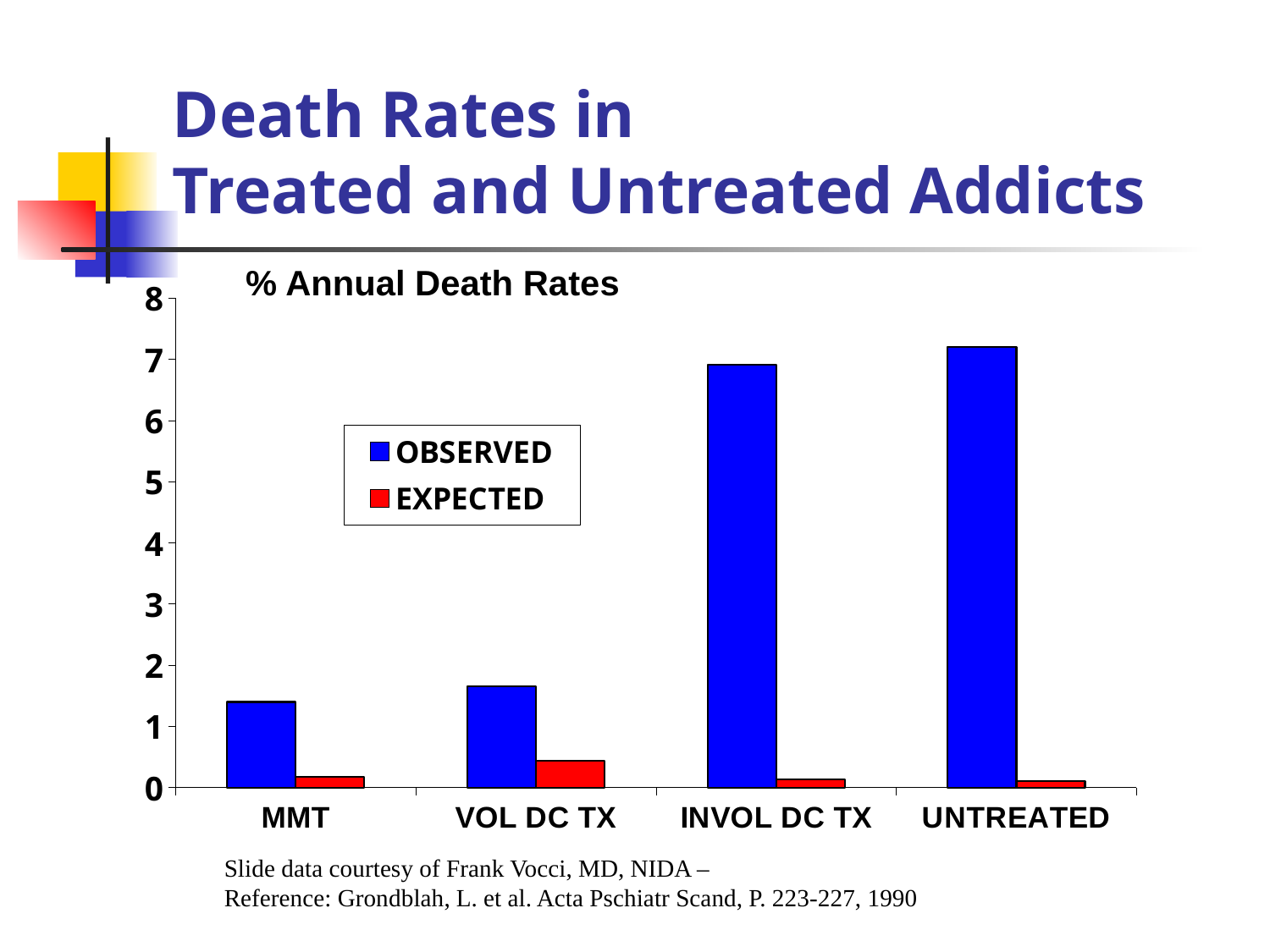
Is the EXPECTED value for VOL DC TX greater or less than 1? less Is the OBSERVED value for UNTREATED greater or less than 6? greater Is the OBSERVED value for VOL DC TX greater or less than 2? less What kind of chart is shown on the slide? bar chart Which is larger, the OBSERVED value for MMT or the OBSERVED value for VOL DC TX? VOL DC TX How many series does the legend list? 2 What colour are the EXPECTED bars? red How many categories are shown on the x axis? 4 Which category has the highest EXPECTED death rate? VOL DC TX Which category has the lowest OBSERVED death rate? MMT